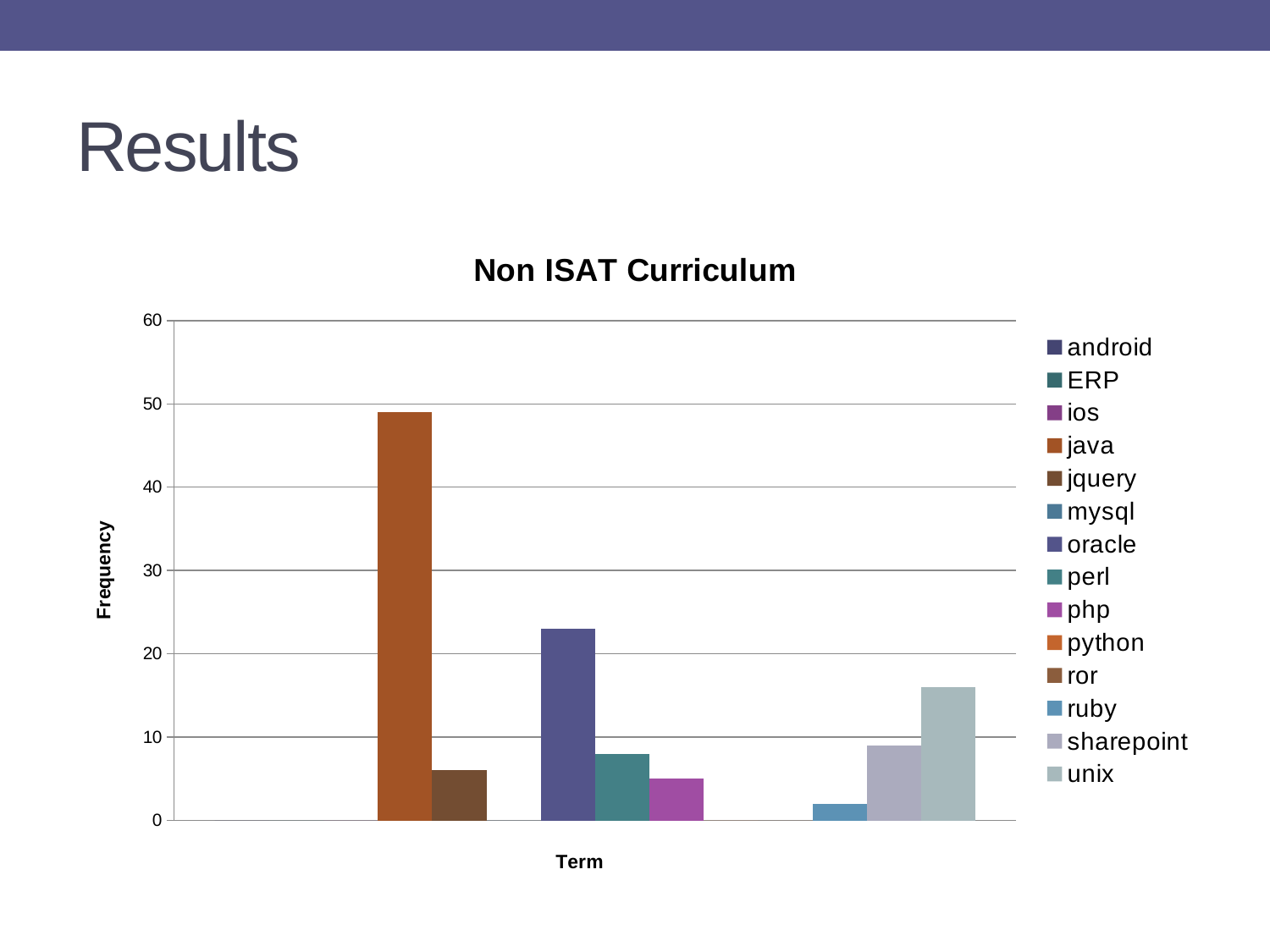
Is the value for ruby greater or less than 10? less Which series has the highest bar in the chart? java Is the value for unix greater or less than 10? greater What is the title of the chart? Non ISAT Curriculum What is the label of the vertical axis? Frequency Is the value for oracle greater or less than 20? greater Which is larger, the value for unix or the value for sharepoint? unix Which series has the lowest visible bar in the chart? ruby Which is larger, the value for java or the value for oracle? java How many series does the legend list? 14 What kind of chart is shown on the slide? bar chart